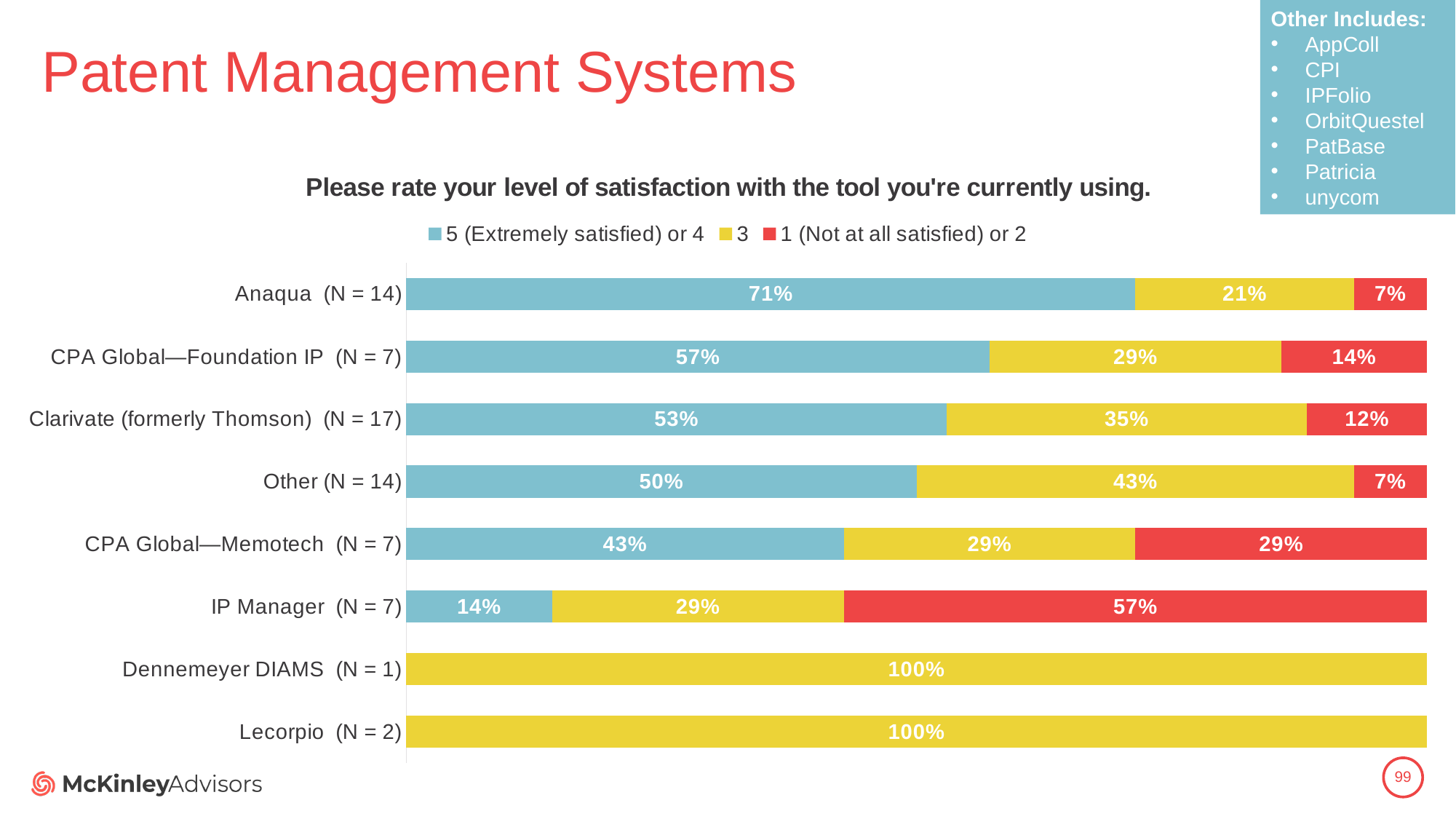
What is the sample size (N) for Clarivate (formerly Thomson)? 17 What kind of chart is shown on the slide? Stacked bar chart What percentage of IP Manager users rated their satisfaction 1 (Not at all satisfied) or 2? 57% What percentage of Other users gave a rating of 3? 43% Which tool has the highest share of 5 (Extremely satisfied) or 4 ratings? Anaqua Which colour represents the rating of 3 in the chart? Yellow What percentage of Anaqua users rated their satisfaction 5 (Extremely satisfied) or 4? 71% How many tools are listed on the chart? 8 What is the difference between the 5 or 4 share for Anaqua and for Clarivate (formerly Thomson)? 18% Which tool has the highest share of 1 (Not at all satisfied) or 2 ratings? IP Manager How many series does the legend list? 3 Which has a larger share of 5 or 4 ratings, CPA Global—Foundation IP or CPA Global—Memotech? CPA Global—Foundation IP